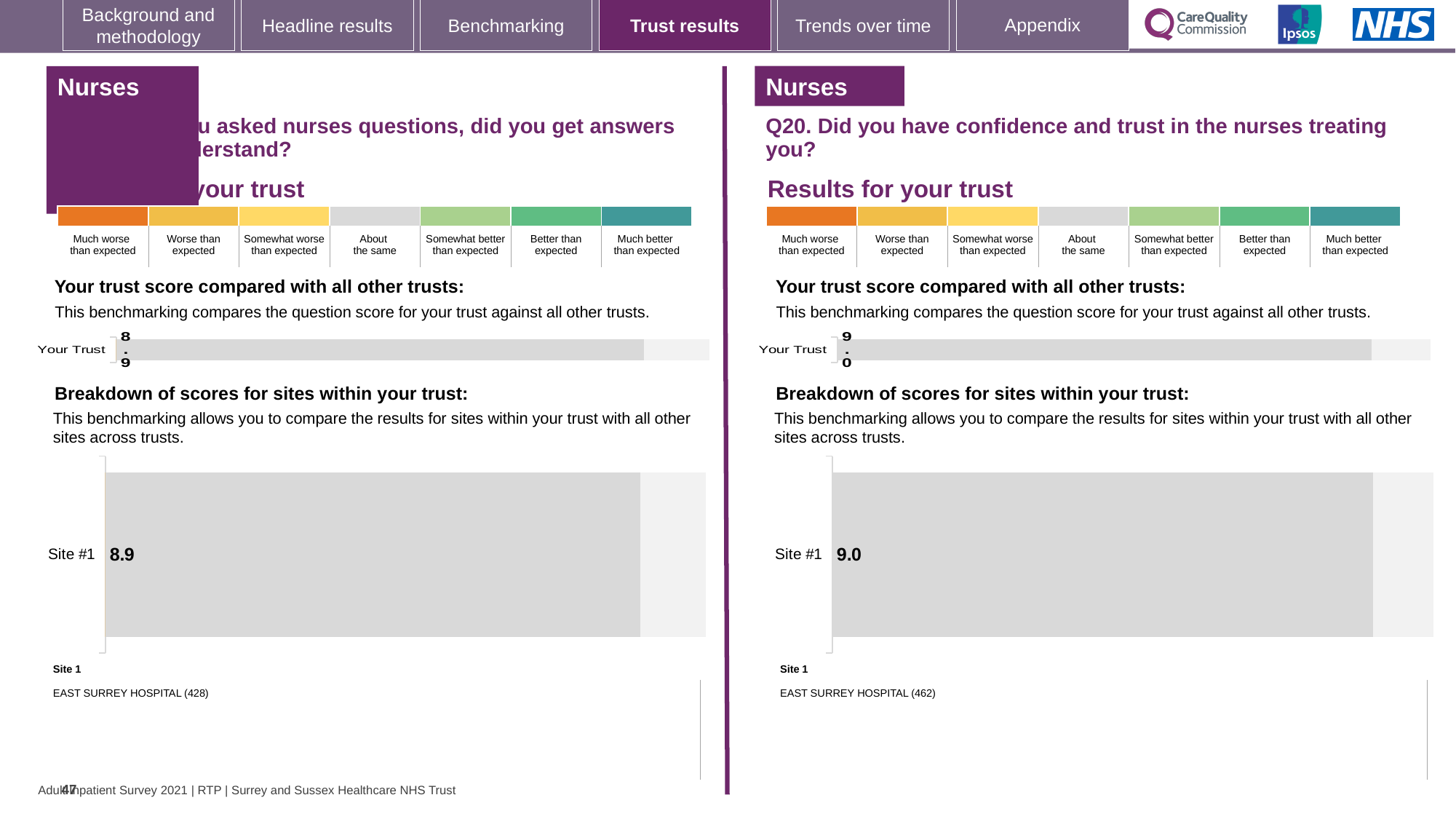
On the right half of the slide (Q20), what is the score shown for Your Trust in the 'Your trust score compared with all other trusts' chart? 9.0 On the left half of the slide, what is the score shown for Your Trust in the 'Your trust score compared with all other trusts' chart? 8.9 On the right half of the slide (Q20), what score is shown for Site #1 in the 'Breakdown of scores for sites within your trust' chart? 9.0 On the left half of the slide, which hospital is listed as Site 1 below the breakdown chart? EAST SURREY HOSPITAL (428) What type of chart is used to show the Your Trust score on the left half of the slide? Bar chart How many sites are shown in the 'Breakdown of scores for sites within your trust' chart on the right half of the slide (Q20)? 1 Which is larger: the Site #1 score in the left-hand breakdown chart or the Site #1 score in the right-hand (Q20) breakdown chart? The right-hand (Q20) chart On the right half of the slide (Q20), which hospital is listed as Site 1 below the breakdown chart? EAST SURREY HOSPITAL (462) What is the difference between the Site #1 score in the right-hand (Q20) breakdown chart and the Site #1 score in the left-hand breakdown chart? 0.1 How many sites are shown in the 'Breakdown of scores for sites within your trust' chart on the left half of the slide? 1 What type of chart is used to show the Site #1 score on the right half of the slide (Q20)? Bar chart On the left half of the slide, what score is shown for Site #1 in the 'Breakdown of scores for sites within your trust' chart? 8.9